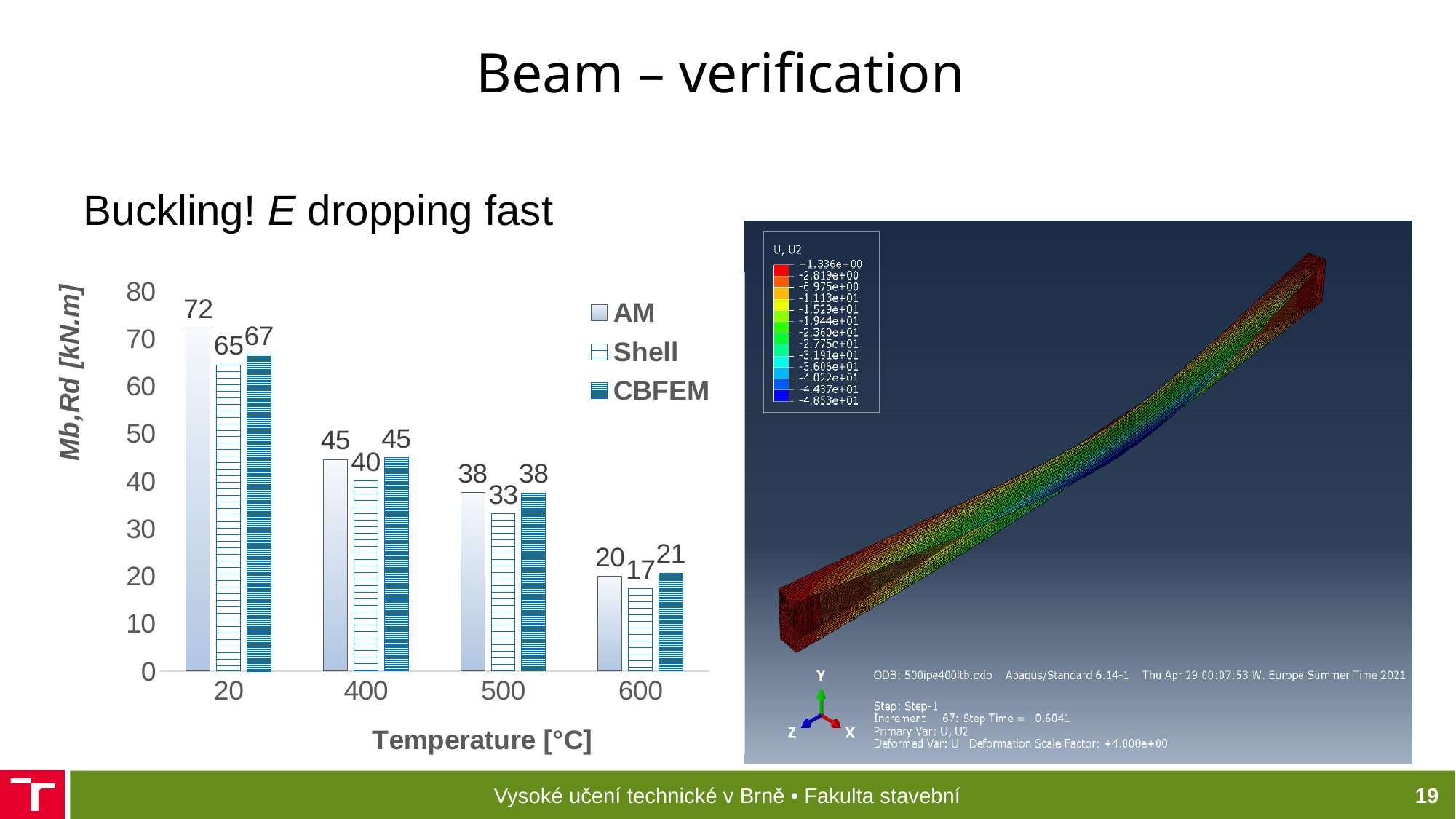
How many temperature categories are shown on the x axis? 4 What is the Shell value at 500 °C? 33 Which is larger at 400 °C, the Shell value or the CBFEM value? CBFEM At which temperature is the AM value highest? 20 How many series does the legend list? 3 At which temperature is the Shell value lowest? 600 What is the CBFEM value at 600 °C? 21 What is the AM value at 20 °C? 72 Do the AM values rise or fall as temperature increases along the x axis? fall What is the label of the y axis? Mb,Rd [kN.m] What kind of chart is shown on the slide? bar chart What is the difference between the AM and Shell values at 20 °C? 7